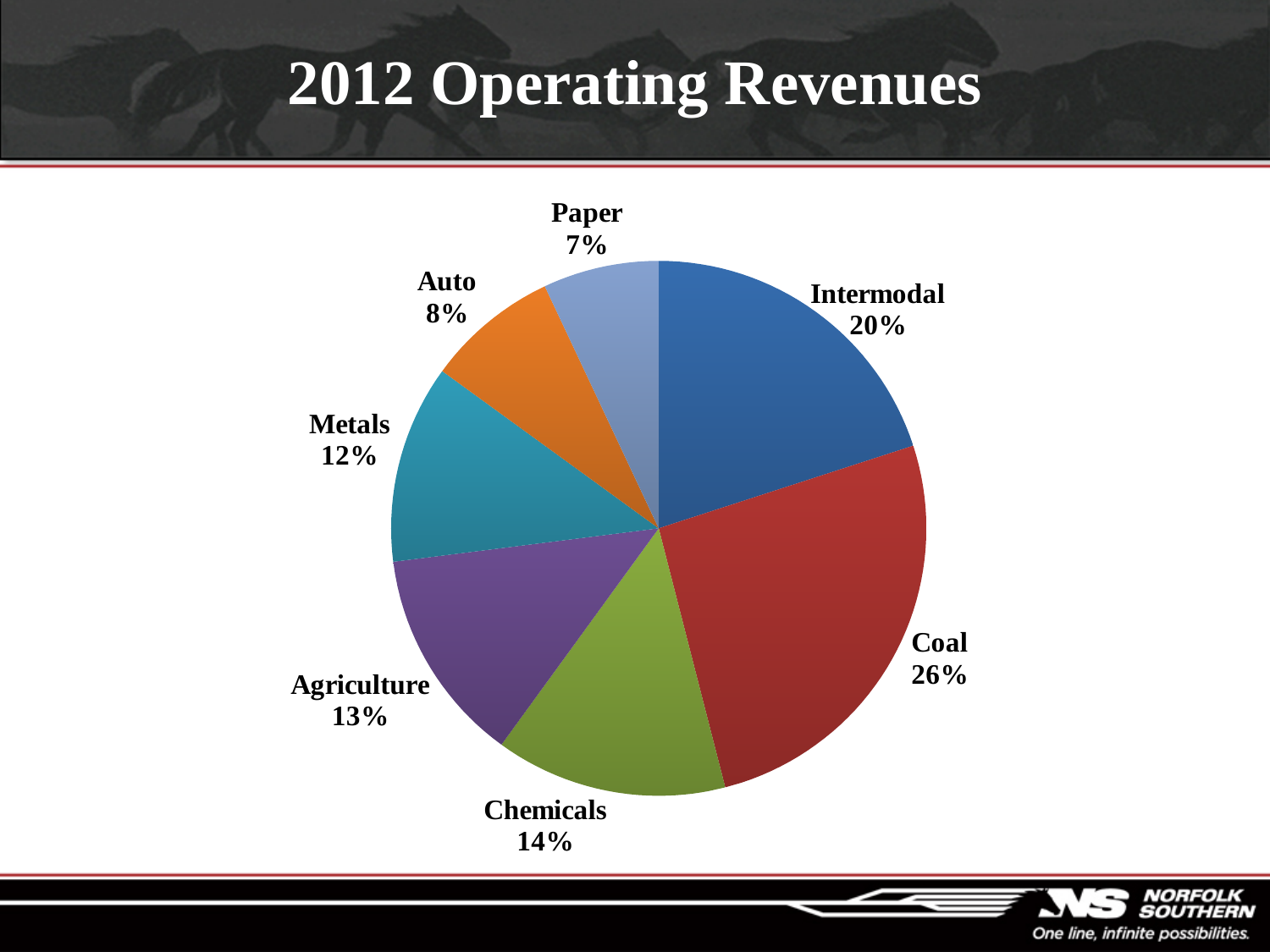
What colour is the Coal slice? Red What percentage is shown for Paper? 7% Which category has the largest share of 2012 operating revenues? Coal What percentage is shown for Chemicals? 14% Which category has the smallest share of 2012 operating revenues? Paper What share of 2012 operating revenues comes from Intermodal? 20% What type of chart is shown on the slide? Pie chart What share of 2012 operating revenues comes from Coal? 26% What is the difference in percentage points between Coal and Intermodal? 6 What is the title of the chart? 2012 Operating Revenues Which is larger, the share for Metals or the share for Agriculture? Agriculture How many categories are shown in the pie chart? 7